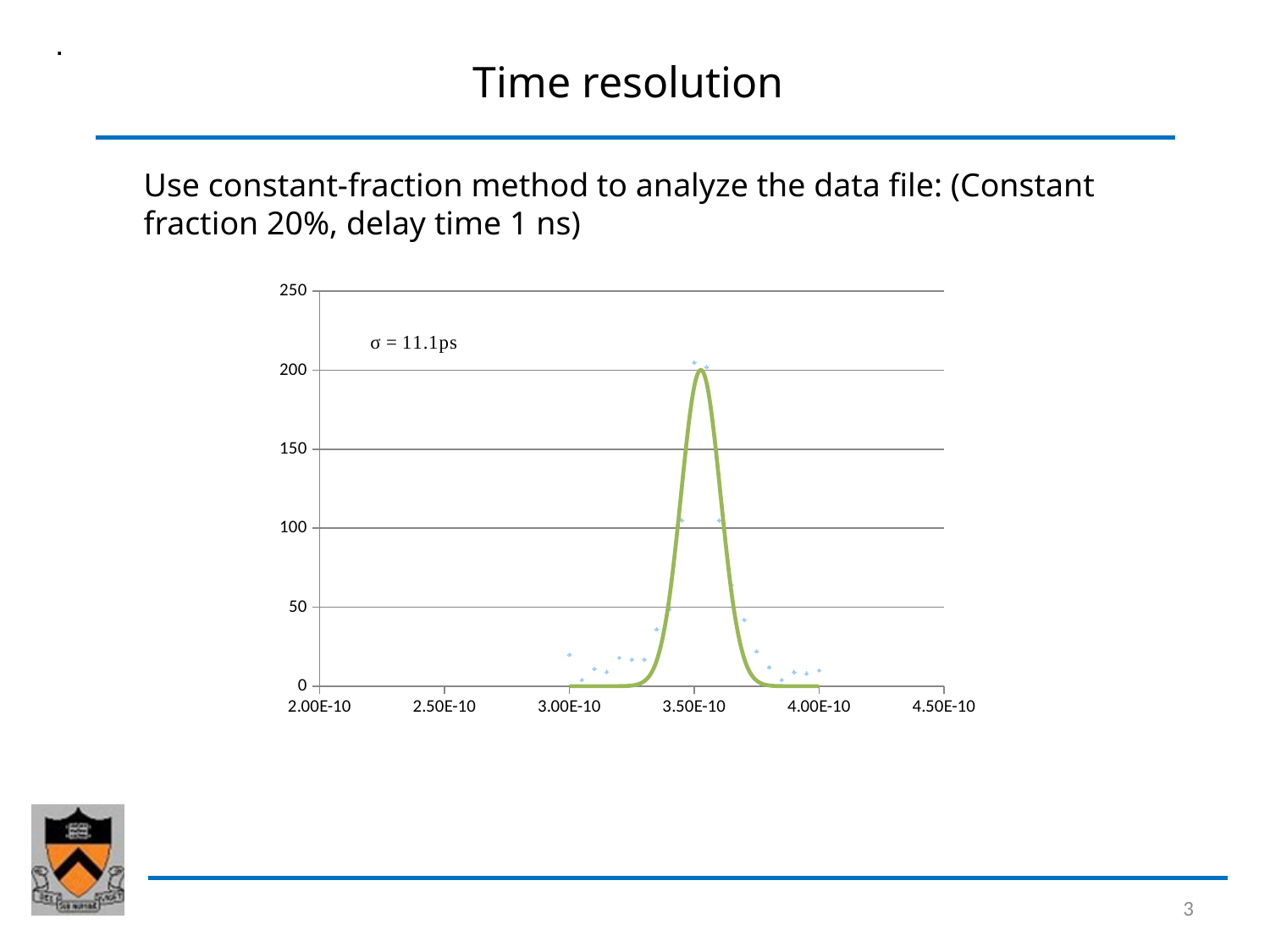
Is the peak of the fitted curve higher or lower than the value at 3.00E-10? higher Around which x-axis tick does the peak of the fitted curve occur? 3.50E-10 Is the value of the data points near 3.00E-10 on the x axis greater or less than 50? less Do the plotted values rise or fall as x increases from 3.50E-10 to 4.00E-10? fall What value of sigma is annotated on the chart? σ = 11.1ps What is the highest value shown on the y axis of the chart? 250 Is the peak value of the plotted data greater or less than 150? greater Do the plotted values rise or fall as x increases from 3.00E-10 to 3.50E-10? rise What kind of chart is shown on the slide? scatter chart with a fitted curve Is the value of the data points near 4.00E-10 on the x axis greater or less than 50? less